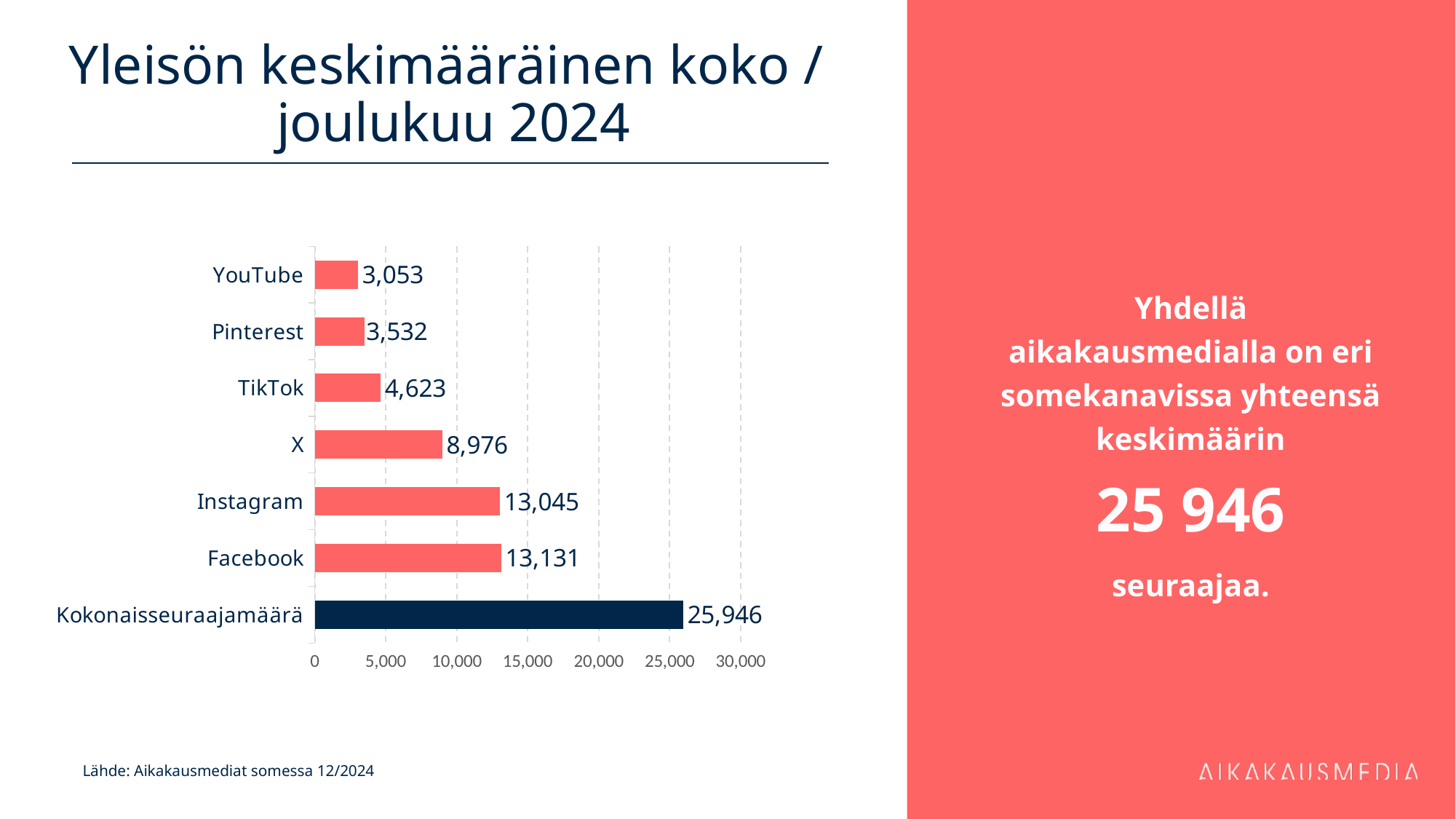
Which category has the highest value? Kokonaisseuraajamäärä What is the value for Kokonaisseuraajamäärä? 25,946 What is the value for Instagram? 13,045 What kind of chart is shown on the slide? bar chart What is the difference between the values for Facebook and Instagram? 86 Which is larger, the value for Pinterest or the value for YouTube? Pinterest Is the value for TikTok greater or less than 5,000? less What is the title of the slide? Yleisön keskimääräinen koko / joulukuu 2024 How many categories are shown in the chart? 7 What is the value for X? 8,976 Which category has the lowest value? YouTube What is the difference between the values for X and TikTok? 4,353